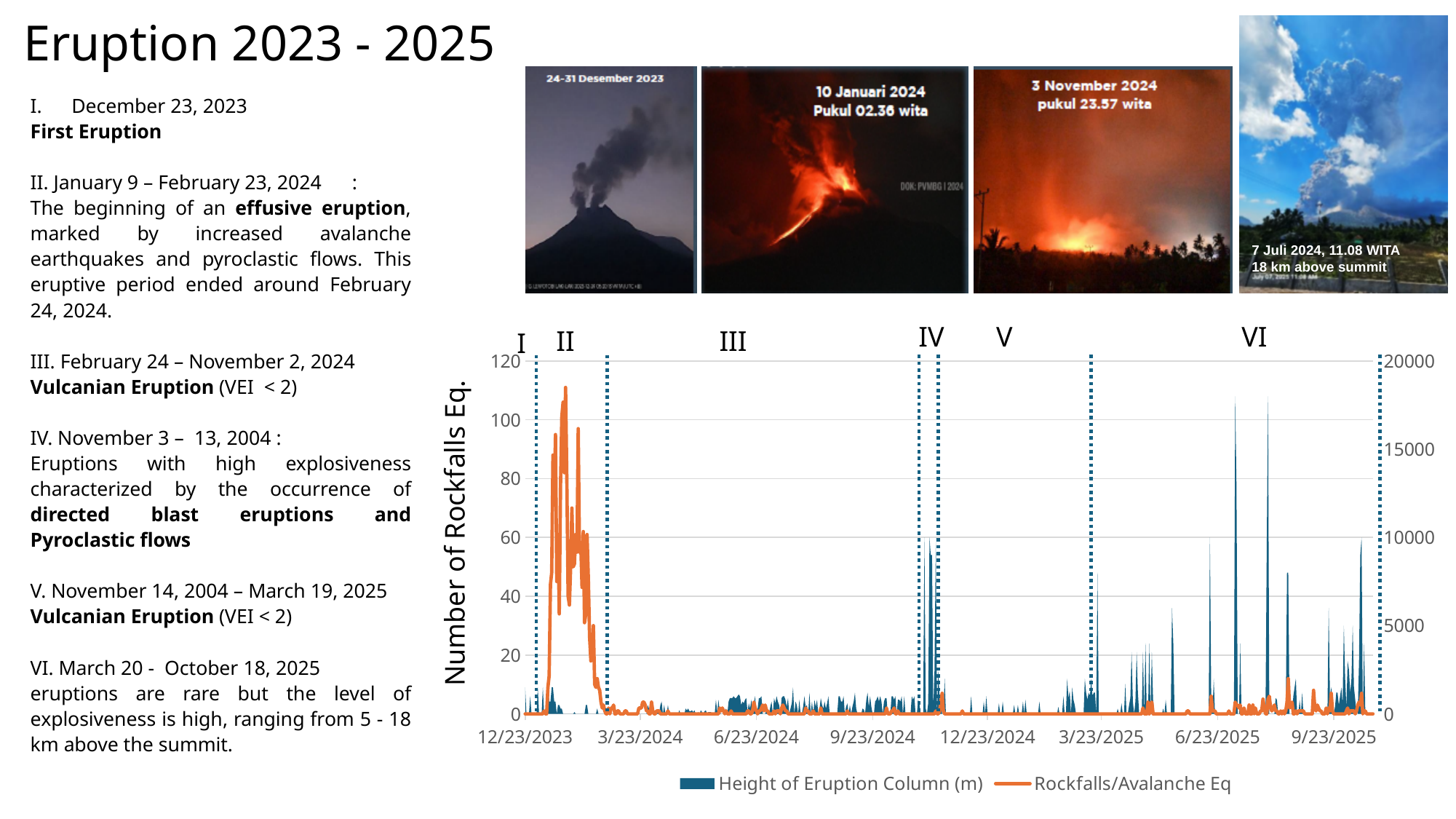
During phase III, is the Rockfalls/Avalanche Eq series greater or less than 20 on the left axis? less Is the highest peak of the Height of Eruption Column (m) series greater or less than 15000 on the right axis? greater How many series does the chart legend list? 2 In which labelled phase does the Height of Eruption Column (m) series reach its highest value? VI What is the title of the left vertical axis of the chart? Number of Rockfalls Eq. What are the two series named in the chart legend? Height of Eruption Column (m) and Rockfalls/Avalanche Eq Is the highest peak of the Rockfalls/Avalanche Eq series greater or less than 100 on the left axis? greater What kind of chart is shown on the slide? combination chart (bar and line) Which series has the higher peak in phase II, Height of Eruption Column (m) or Rockfalls/Avalanche Eq? Rockfalls/Avalanche Eq How many eruption phases are marked with Roman numerals above the chart? 6 What is the first date label on the x axis of the chart? 12/23/2023 In which labelled phase does the Rockfalls/Avalanche Eq series reach its highest value? II